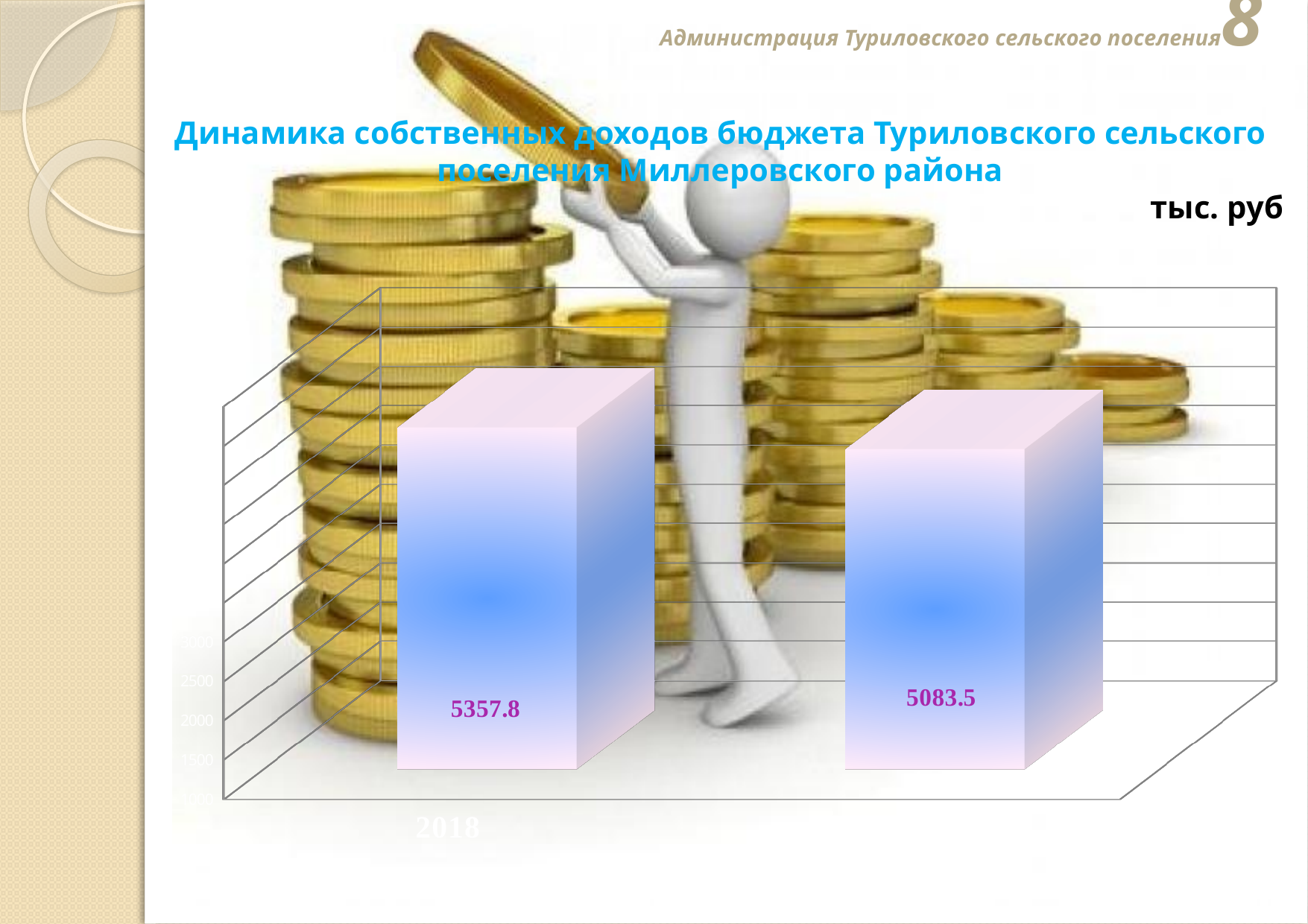
What is the value shown on the right-hand bar of the chart? 5083.5 What kind of chart is shown on the slide? Bar chart What is the highest value shown in the chart? 5357.8 Is the value for 2018 greater or less than 3000? greater What is the value of the bar for 2018? 5357.8 How many bars are plotted in the chart? 2 In what units are the chart values given, according to the slide? тыс. руб Which bar is higher, the left bar (2018) or the right bar? The left bar (2018) What is the title of the chart? Динамика собственных доходов бюджета Туриловского сельского поселения Миллеровского района Do the values rise or fall from the left bar to the right bar? Fall What is the difference between the two bar values, 5357.8 and 5083.5? 274.3 What is the lowest value shown in the chart? 5083.5